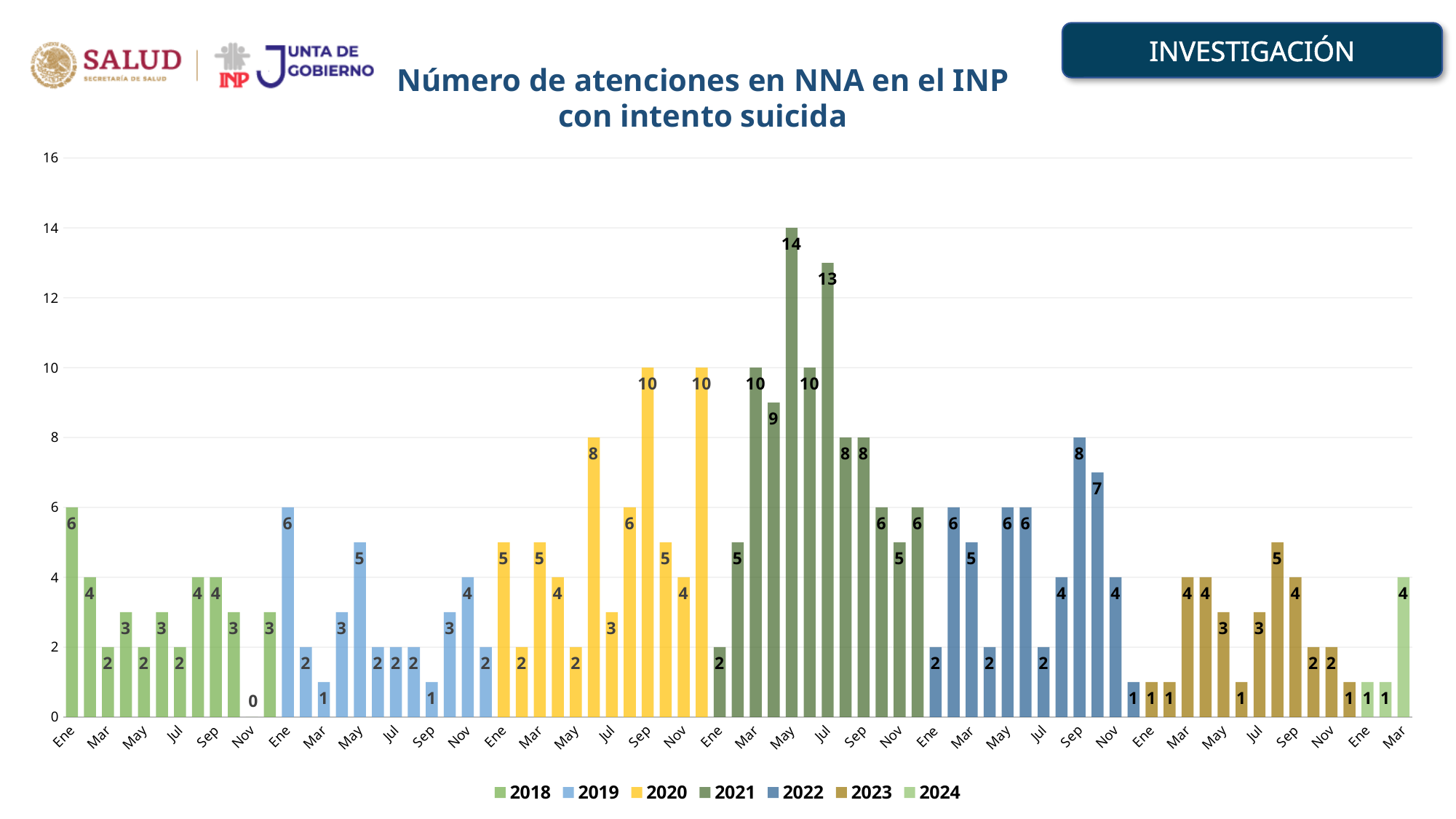
What is the difference between the May 2021 value and the Jul 2021 value? 1 What is the value for Jul 2021? 13 What is the value for Sep 2022? 8 How many series (years) does the legend list? 7 What is the highest value shown in the chart, and in which month and year does it occur? 14, May 2021 What is the value for Nov 2018? 0 What is the value for Mar 2024? 4 What is the value for Ene (January) 2018? 6 What kind of chart is shown on the slide? bar chart How many months are plotted for the 2024 series? 3 Which is larger, the value for Sep 2020 or the value for Sep 2022? Sep 2020 What is the title of the chart? Número de atenciones en NNA en el INP con intento suicida